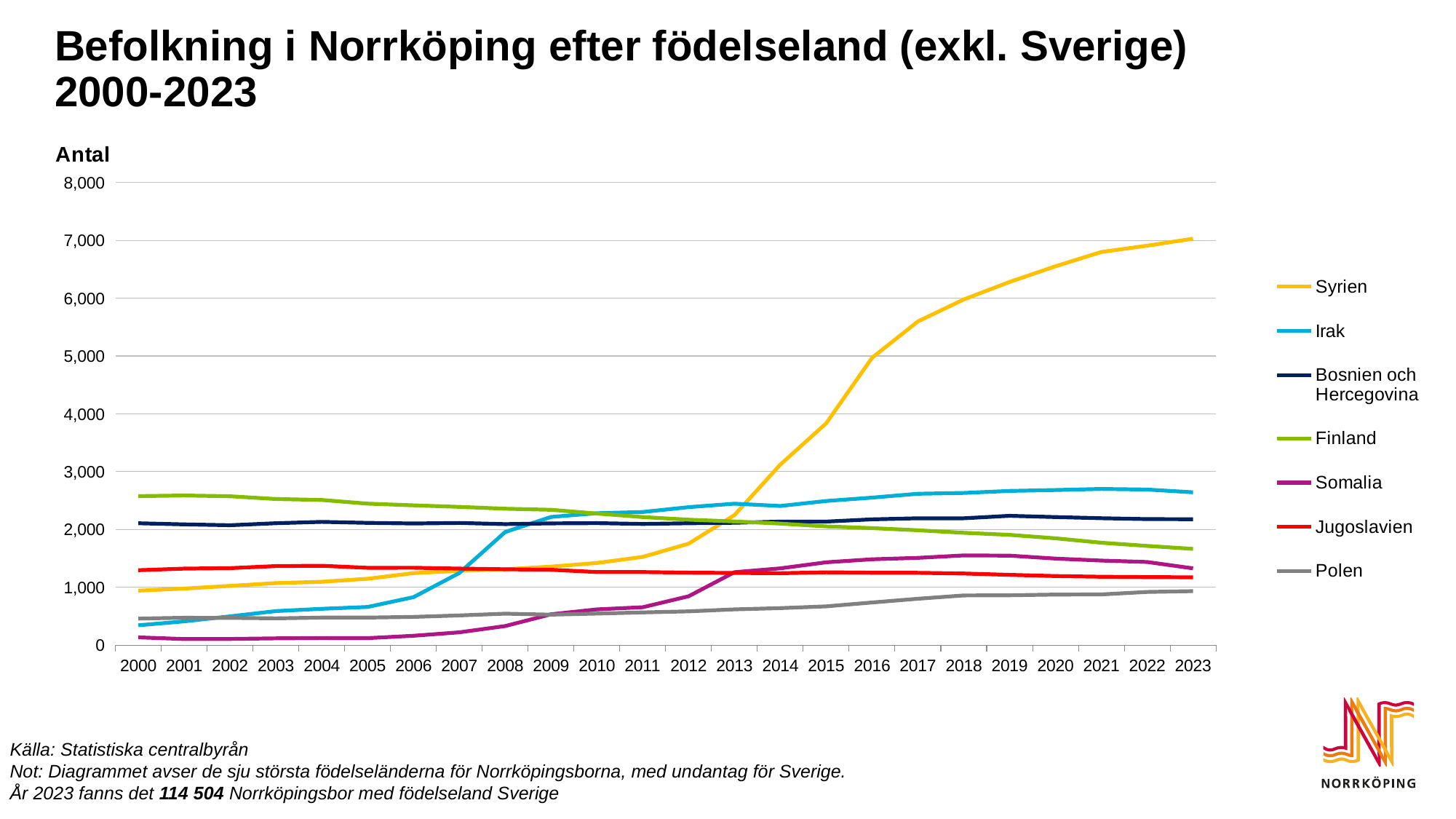
How many years are shown along the x axis? 24 Which birth country has the lowest value in 2023? Polen In 2023, which is larger: the value for Irak or the value for Bosnien och Hercegovina? Irak What kind of chart is shown on the slide? line chart How many series does the legend list? 7 Is the value for Syrien in 2023 greater or less than 6,000? greater Does the line for Finland rise or fall from 2000 to 2023? fall Which birth country has the highest value in 2023? Syrien Is the value for Somalia in 2023 greater or less than 2,000? less What is the title of the chart? Befolkning i Norrköping efter födelseland (exkl. Sverige) 2000-2023 Which birth country has the lowest value in 2000? Somalia Which birth country has the highest value in 2000? Finland